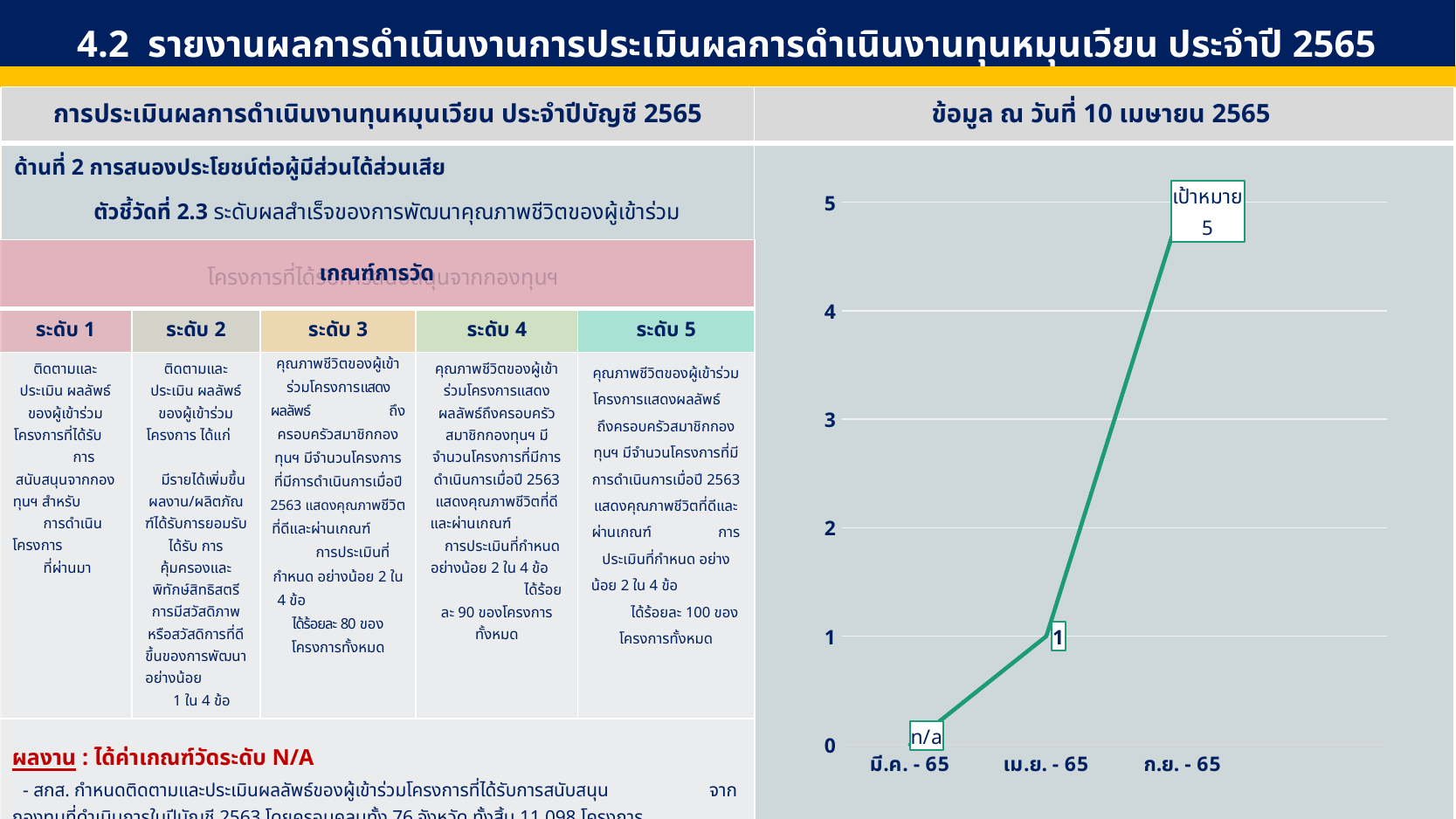
What kind of chart is shown on the right side of the slide? line chart Is the value for ก.ย. - 65 greater or less than 4? greater Which category has the highest plotted value? ก.ย. - 65 What label is shown at the data point for มี.ค. - 65? n/a How many categories are shown on the x axis of the chart? 3 What is the value plotted for เม.ย. - 65? 1 What word appears in the label box above the ก.ย. - 65 data point? เป้าหมาย What is the highest value shown on the y axis of the chart? 5 Do the plotted values rise or fall from left to right along the x axis? rise What is the difference between the values for ก.ย. - 65 and เม.ย. - 65? 4 What is the value plotted for ก.ย. - 65? 5 Which is larger, the value for เม.ย. - 65 or the value for ก.ย. - 65? ก.ย. - 65